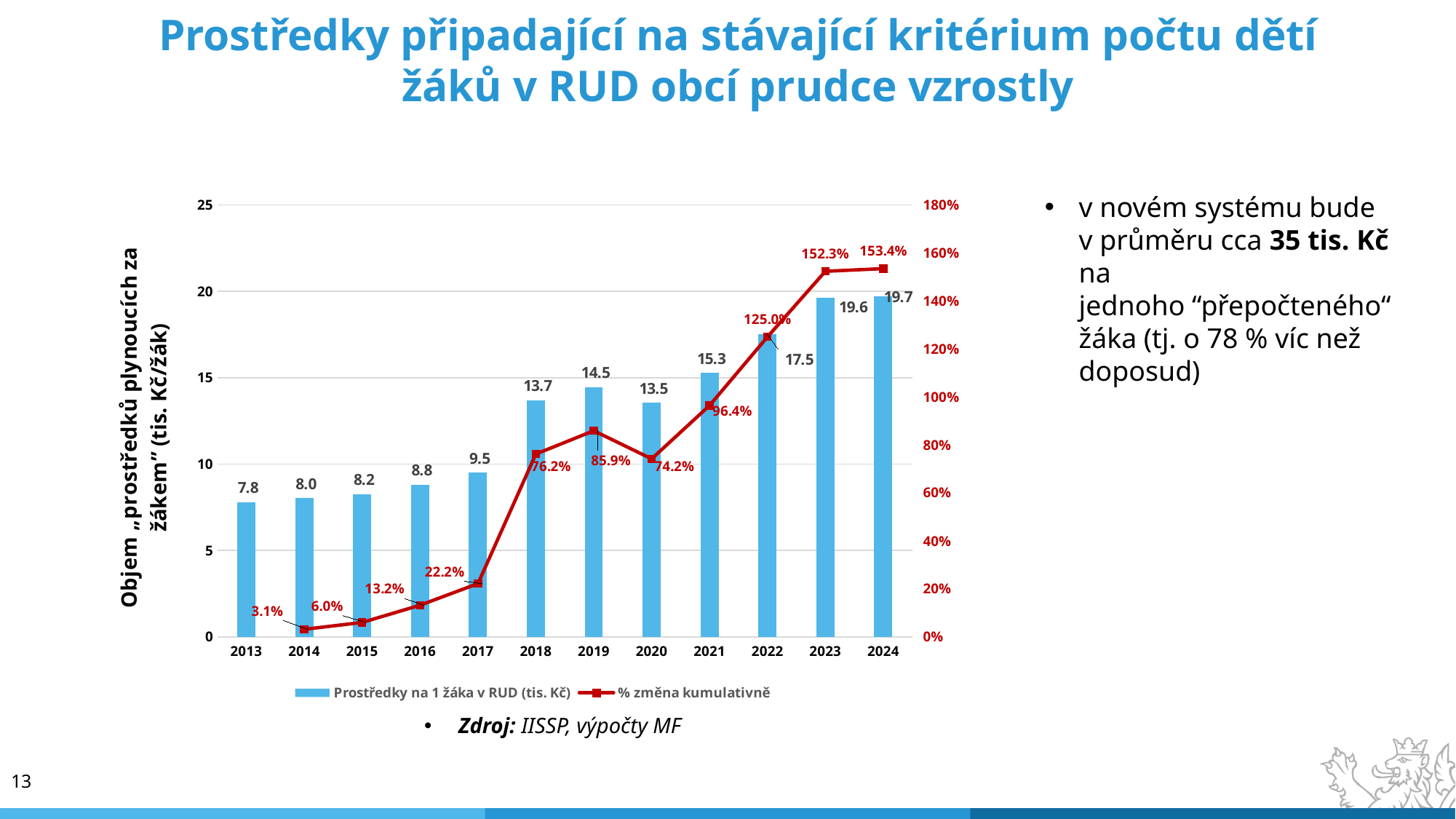
How many years are shown on the x axis of the chart? 12 What is the value of 'Prostředky na 1 žáka v RUD (tis. Kč)' for 2013? 7.8 What is the label of the left vertical axis of the chart? Objem „prostředků plynoucích za žákem" (tis. Kč/žák) Which year has the highest cumulative percentage change ('% změna kumulativně')? 2024 Which year has a larger 'Prostředky na 1 žáka v RUD (tis. Kč)' value, 2019 or 2020? 2019 What is the value of 'Prostředky na 1 žáka v RUD (tis. Kč)' for 2018? 13.7 How many series does the chart legend list? 2 What is the cumulative percentage change ('% změna kumulativně') shown for 2022? 125.0% What kind of chart is shown on the slide? Combined bar and line chart Is the cumulative percentage change for 2021 greater or less than 100%? less What is the difference between the 'Prostředky na 1 žáka v RUD (tis. Kč)' values for 2022 and 2021? 2.2 Which year has the lowest value of 'Prostředky na 1 žáka v RUD (tis. Kč)'? 2013